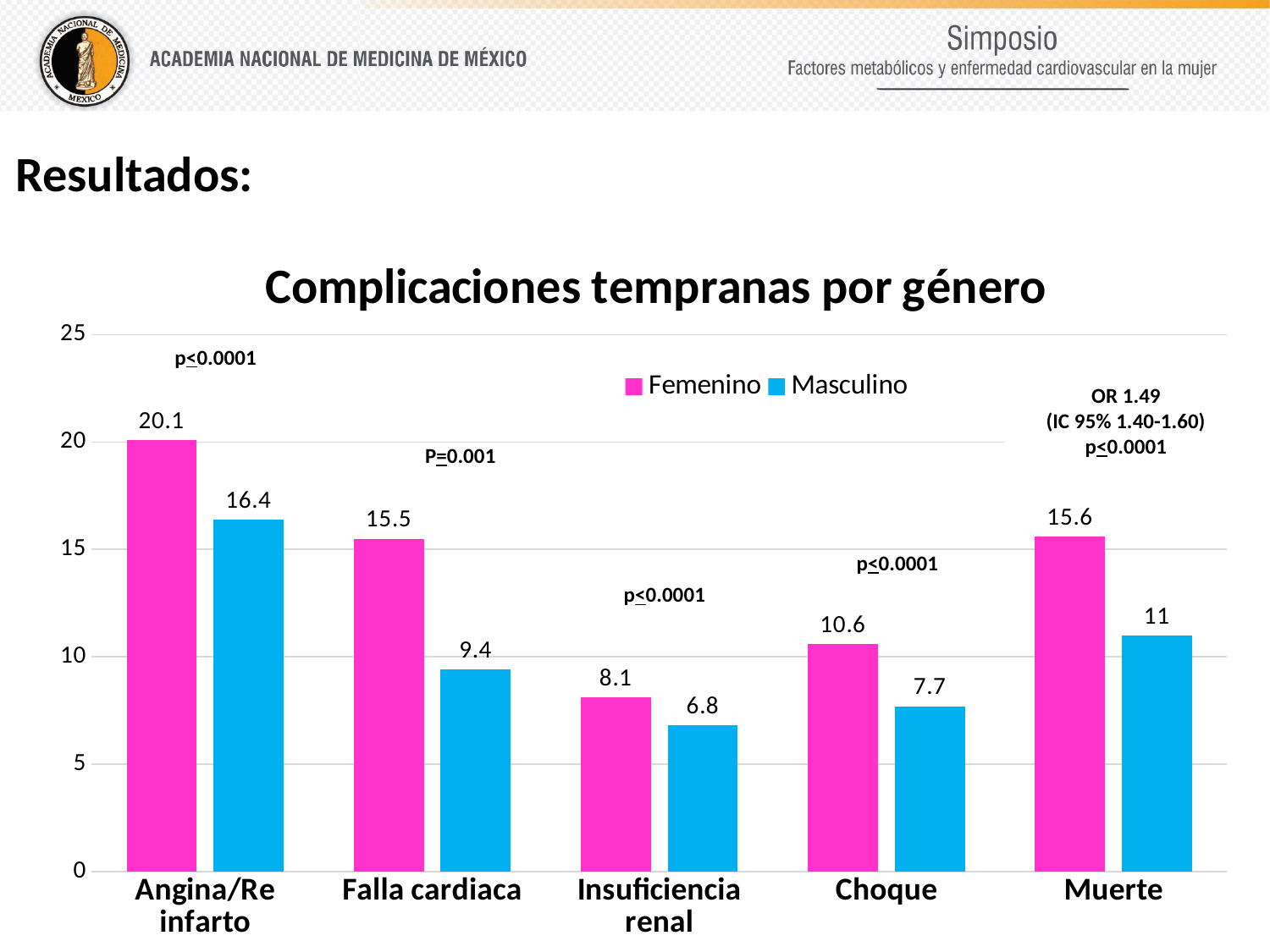
What kind of chart is shown? Bar chart What colour represents the Masculino series? Blue What is the Masculino value for Falla cardiaca? 9.4 What is the Femenino value for Angina/Re infarto? 20.1 Which category has the lowest Masculino value? Insuficiencia renal What is the difference between the Femenino and Masculino values for Choque? 2.9 What is the title of the chart? Complicaciones tempranas por género What is the Masculino value for Muerte? 11 How many categories are shown on the x axis? 5 Which is larger for Insuficiencia renal, the Femenino value or the Masculino value? Femenino Which category has the highest Femenino value? Angina/Re infarto How many series does the legend list? 2